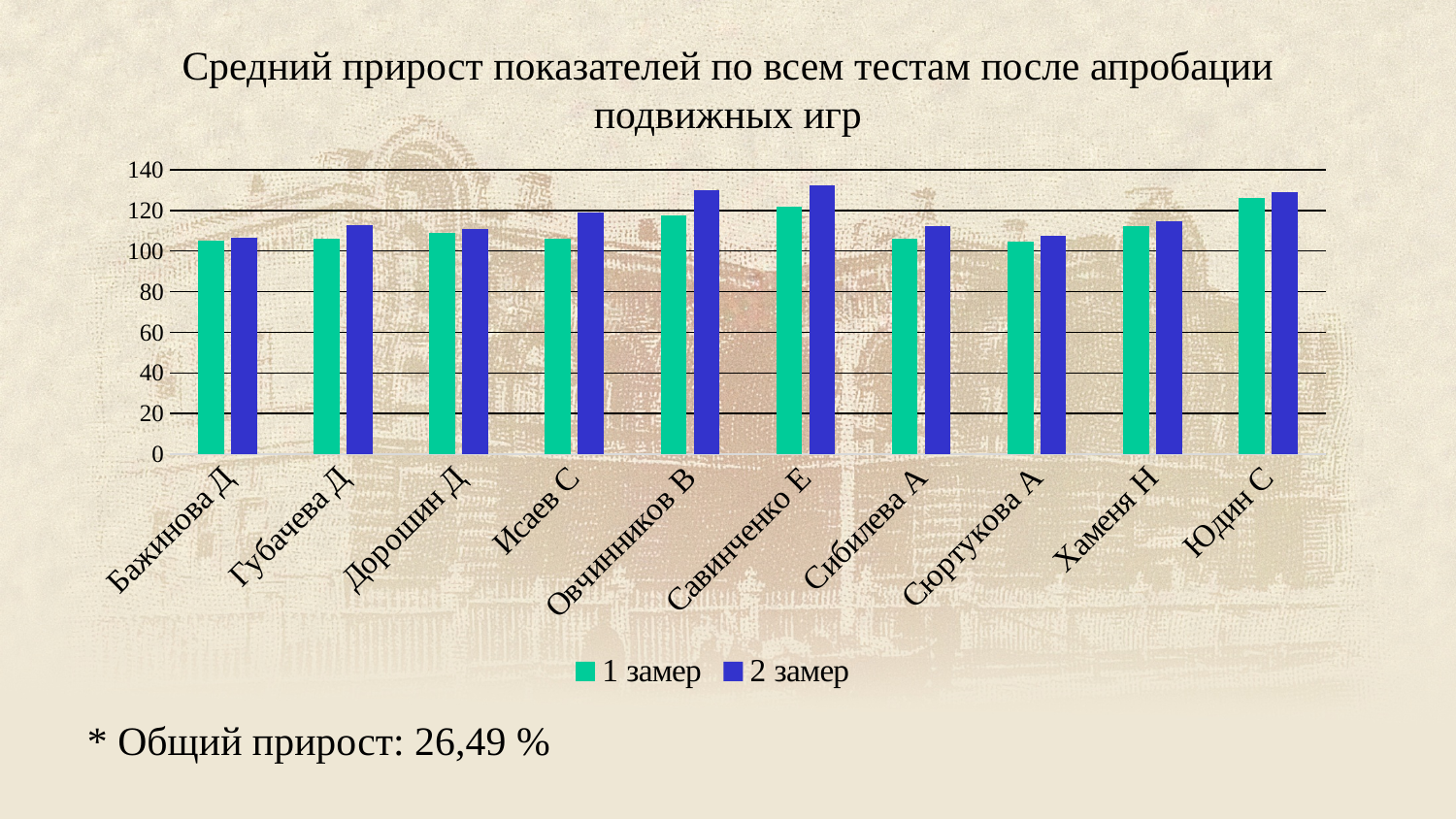
Is the 2 замер value for Сюртукова А greater or less than 120? less Is the 2 замер value for Овчинников В greater or less than 120? greater What are the two series named in the chart legend? 1 замер and 2 замер Is the 1 замер value for Юдин С greater or less than 120? greater How many people (categories) are shown on the x axis of the chart? 10 Which is larger: the 2 замер value for Савинченко Е or the 2 замер value for Бажинова Д? Савинченко Е How many series does the chart legend list? 2 Which is larger: the 1 замер value for Овчинников В or the 1 замер value for Губачева Д? Овчинников В What is the title of the chart? Средний прирост показателей по всем тестам после апробации подвижных игр What kind of chart is shown on the slide? bar chart